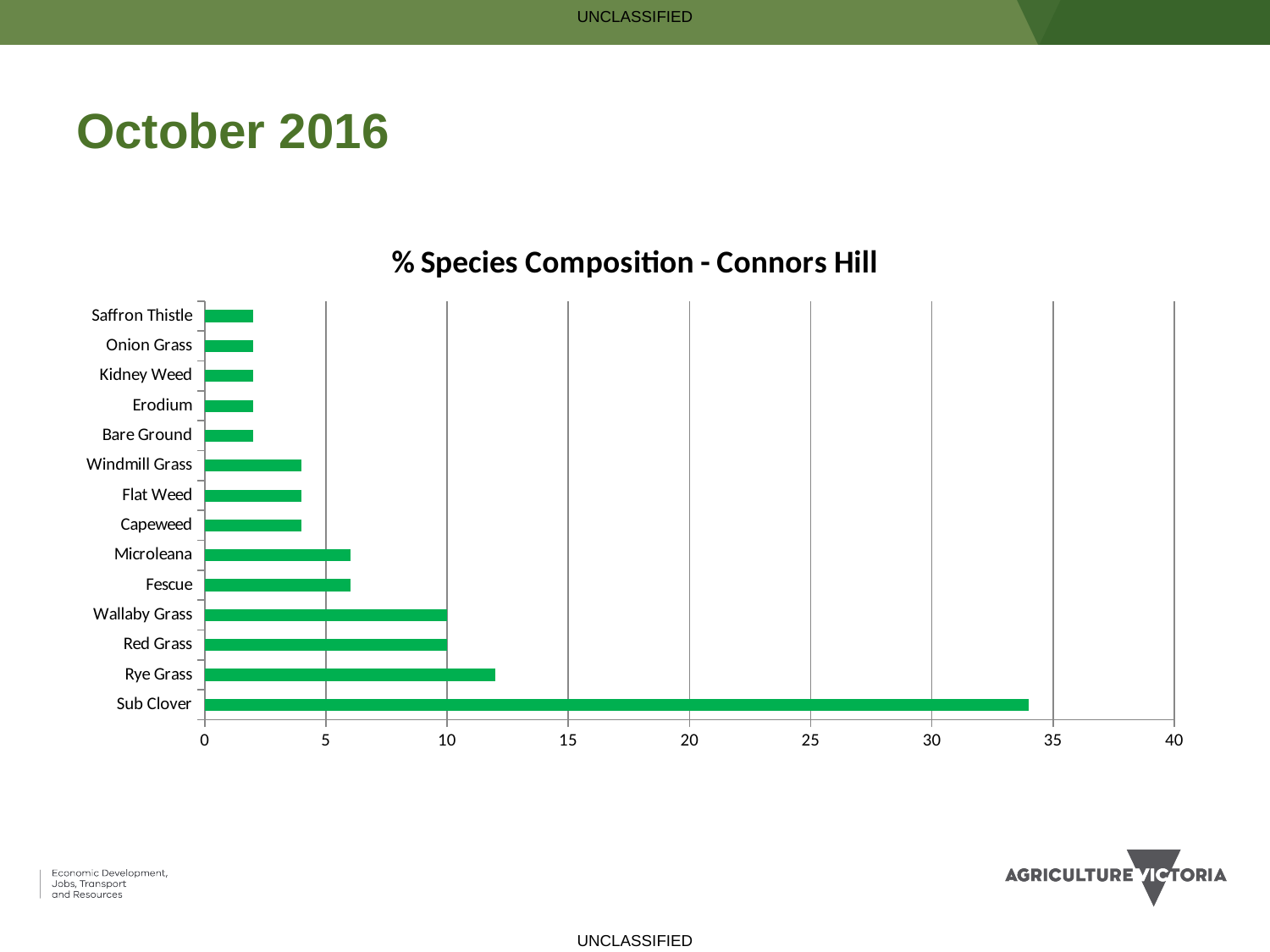
Is the value for Fescue greater or less than 5? greater Which category has the highest value? Sub Clover What kind of chart is shown on the slide? bar chart Which is larger, the value for Microleana or the value for Windmill Grass? Microleana What is the title of the chart? % Species Composition - Connors Hill Is the value for Rye Grass greater or less than 10? greater Is the value for Capeweed greater or less than 5? less Which is larger, the value for Rye Grass or the value for Fescue? Rye Grass What is the value for Red Grass? 10 How many species/categories are plotted in the chart? 14 What is the value for Wallaby Grass? 10